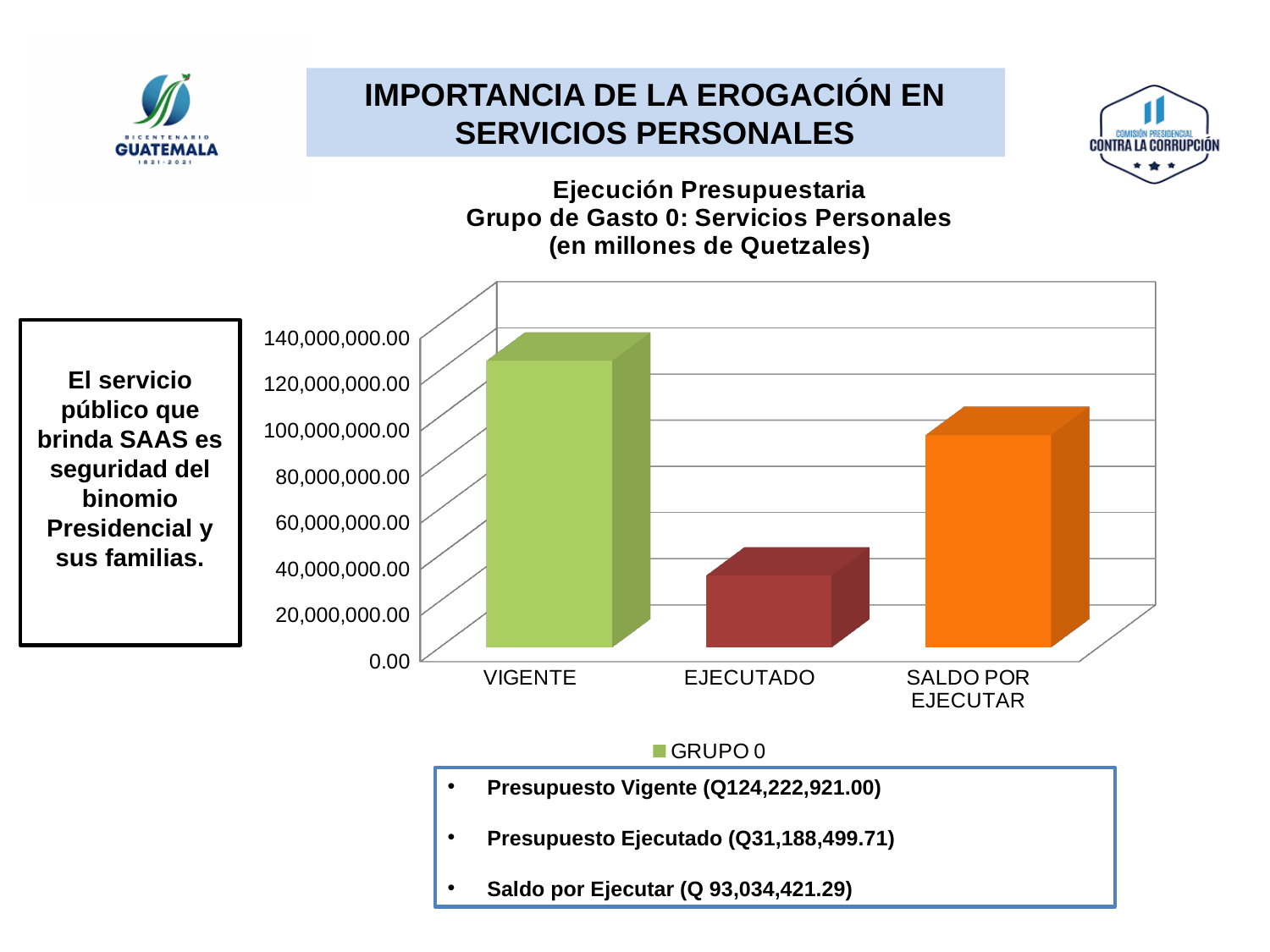
How many series does the chart legend list? 1 Which category has the lowest bar in the chart? EJECUTADO Which category has the highest bar in the chart? VIGENTE According to the slide, what is the value of the Presupuesto Ejecutado? Q31,188,499.71 How many categories are shown on the x axis of the chart? 3 According to the slide, what is the value of the Presupuesto Vigente? Q124,222,921.00 What is the name of the series listed in the chart legend? GRUPO 0 Which is larger, the bar for SALDO POR EJECUTAR or the bar for EJECUTADO? SALDO POR EJECUTAR Is the value for SALDO POR EJECUTAR greater or less than 80,000,000.00? greater Is the value for EJECUTADO greater or less than 40,000,000.00? less What kind of chart is shown on the slide? bar chart Is the value for VIGENTE greater or less than 120,000,000.00? greater